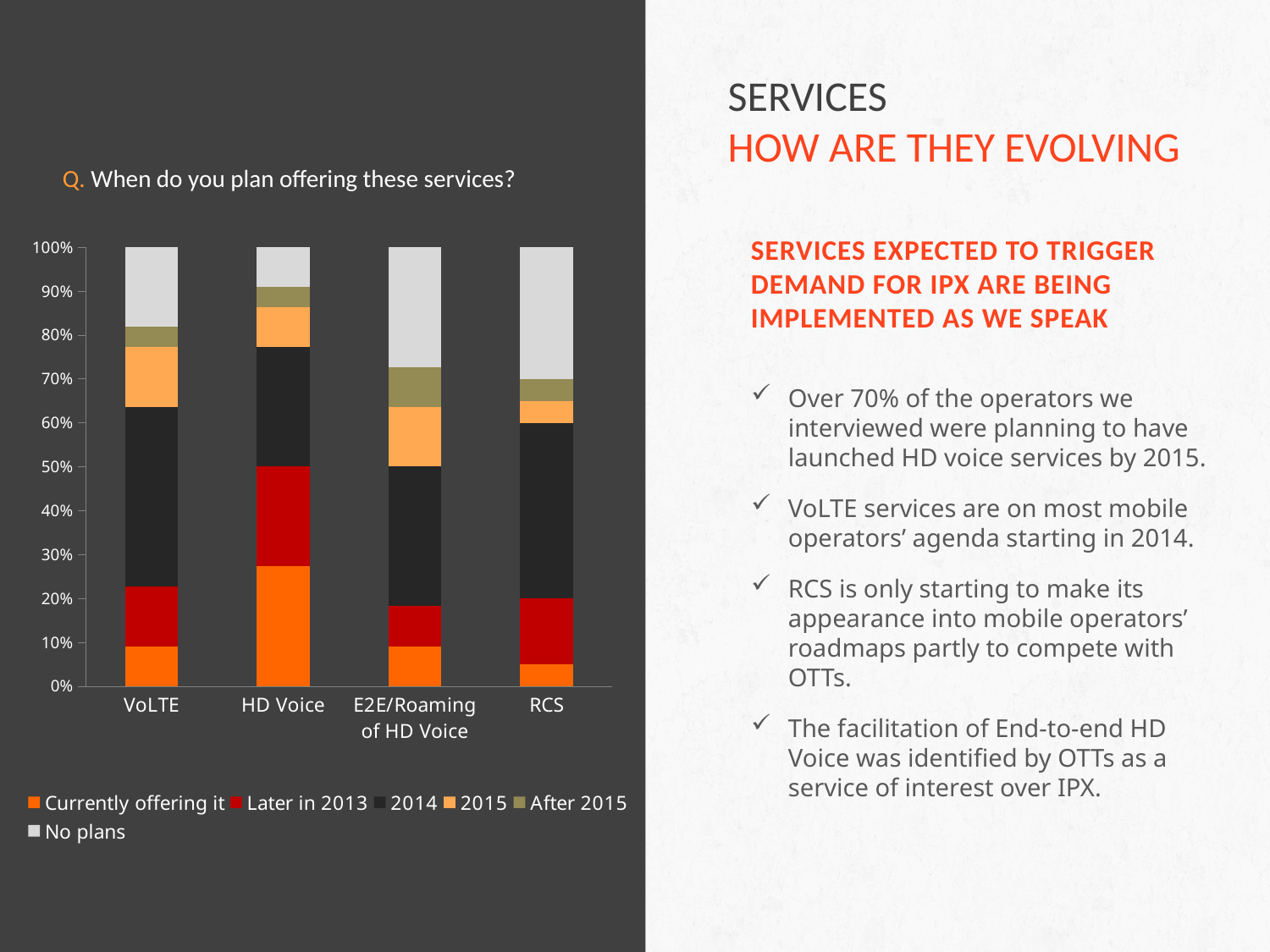
Which service has the largest 'Currently offering it' share? HD Voice Is the 'No plans' share for RCS greater or less than 20%? greater Which service has the smallest 'No plans' share? HD Voice What is the first entry in the chart legend? Currently offering it Which has the larger 'No plans' share, VoLTE or HD Voice? VoLTE Which has the larger 'Currently offering it' share, VoLTE or HD Voice? HD Voice Is the 'Currently offering it' share for VoLTE greater or less than 20%? less What kind of chart is shown on the slide? Stacked bar chart Is the 'Currently offering it' share for HD Voice greater or less than 20%? greater How many series does the chart legend list? 6 How many service categories are shown on the x axis of the chart? 4 What question is the chart titled with? Q. When do you plan offering these services?